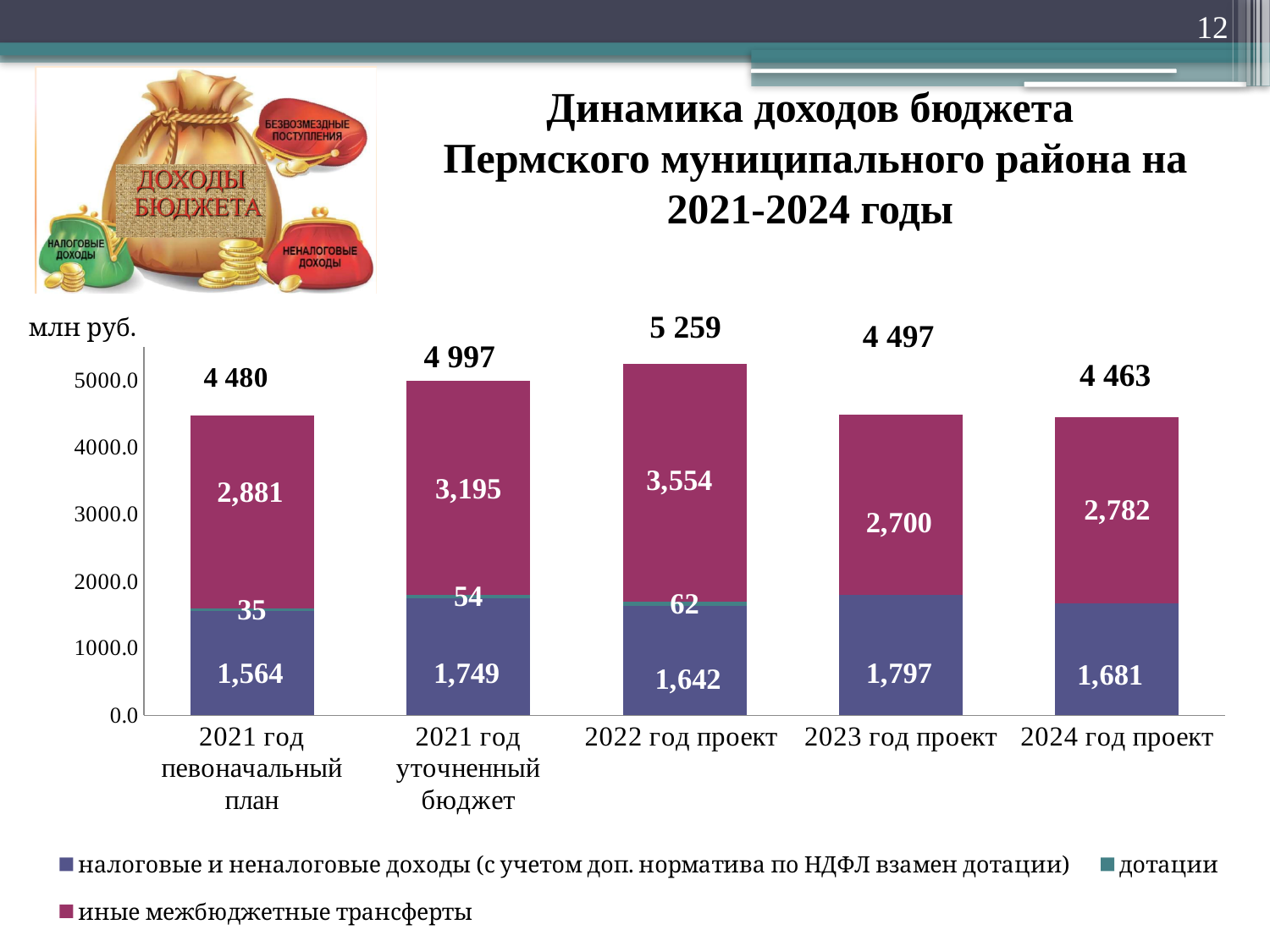
What unit is indicated at the top left of the chart's y axis? млн руб. What is the value of "налоговые и неналоговые доходы" for "2023 год проект"? 1,797 What is the value of "иные межбюджетные трансферты" for "2021 год уточненный бюджет"? 3,195 How many series does the chart legend list? 3 Which category has the lowest value of "иные межбюджетные трансферты"? 2023 год проект What is the value of "дотации" for "2021 год певоначальный план"? 35 What is the total value printed above the bar for "2022 год проект"? 5 259 What type of chart is shown on the slide? stacked bar chart Which category has the highest total value? 2022 год проект Which is larger: "налоговые и неналоговые доходы" for "2024 год проект" or for "2023 год проект"? 2023 год проект What is the difference between the total for "2021 год уточненный бюджет" and the total for "2021 год певоначальный план"? 517 How many categories are shown on the x axis of the chart? 5